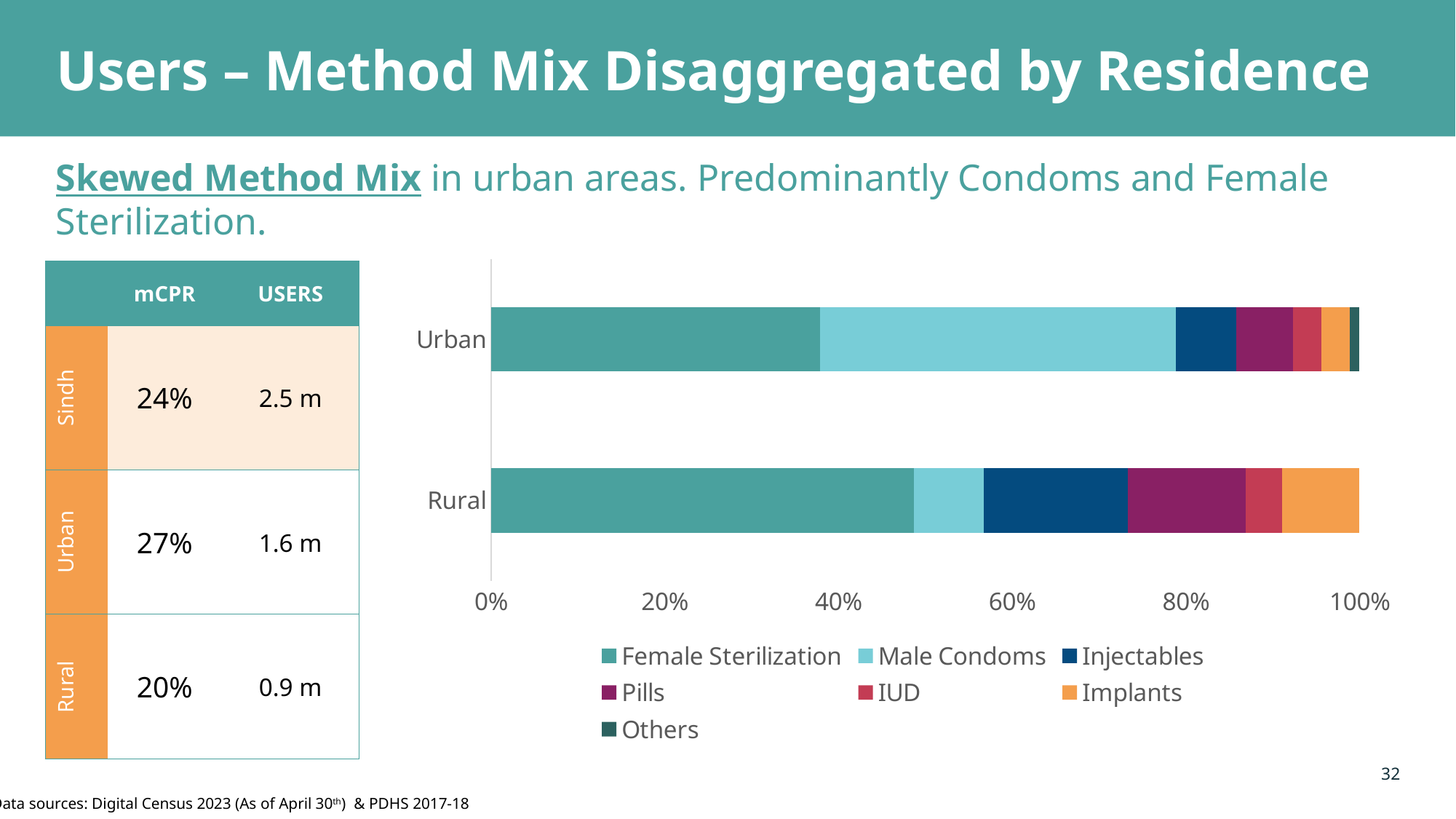
Which residence category has the larger share of Implants, Urban or Rural? Rural How many series does the chart legend list? 7 Which residence category has the larger share of Injectables, Urban or Rural? Rural How many residence categories are plotted in the bar chart? 2 Is the Female Sterilization share for Urban greater or less than 40%? less Which residence category has the larger share of Female Sterilization, Urban or Rural? Rural Is the Female Sterilization share for Rural greater or less than 40%? greater What is the highest value shown on the chart's horizontal axis? 100% Is the Male Condoms share for Rural greater or less than 20%? less Which series in the chart is shown in orange? Implants What kind of chart is shown on the slide? Stacked bar chart